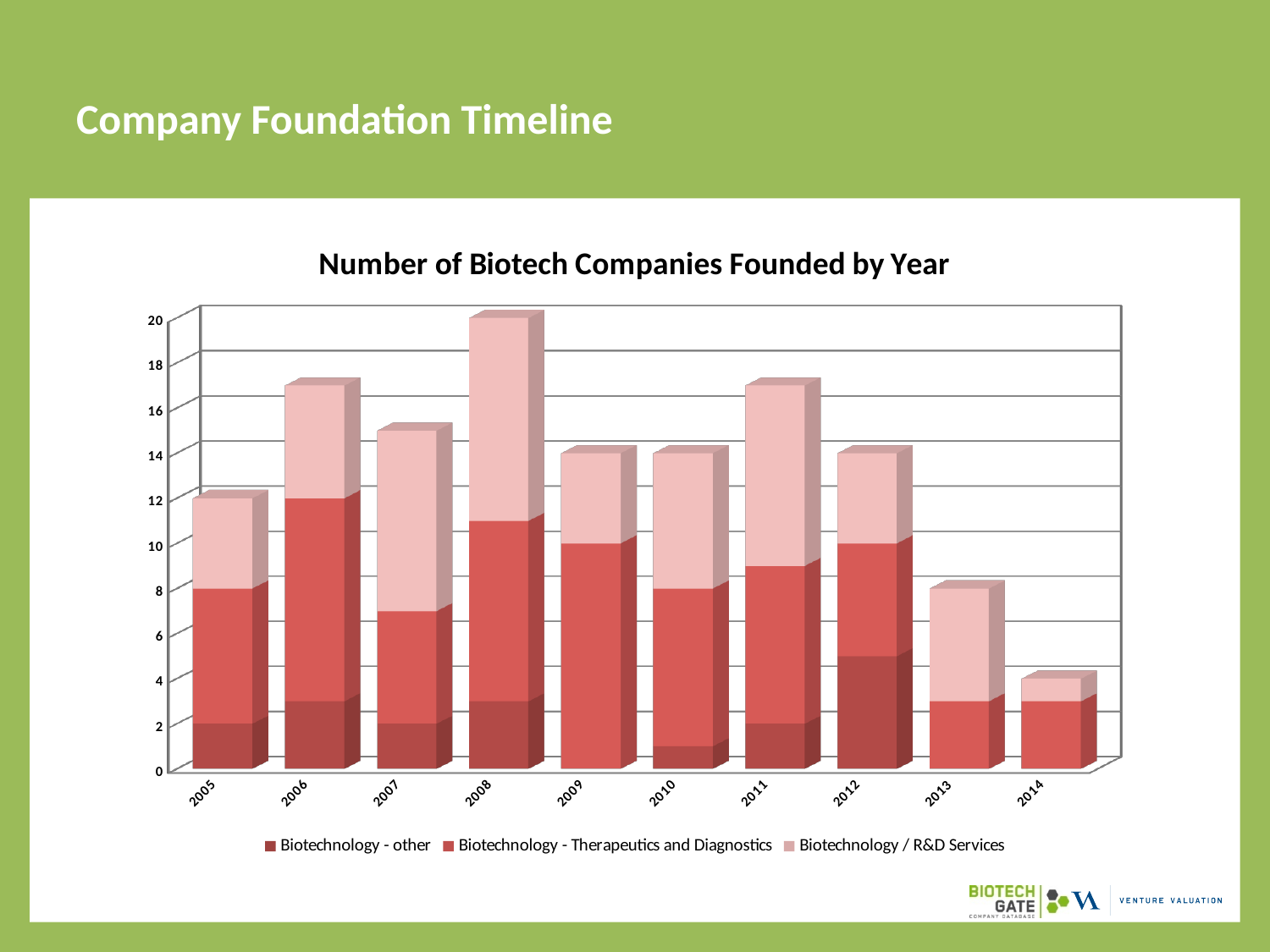
Is the total for 2013 greater or less than 10? less Which year has a larger total, 2006 or 2013? 2006 How many series does the legend list? 3 Which year has the highest total number of biotech companies founded? 2008 What is the title of the chart? Number of Biotech Companies Founded by Year Is the total for 2014 greater or less than 6? less Which year has the lowest total number of biotech companies founded? 2014 Do the totals rise or fall from 2012 to 2014? fall What kind of chart is shown on the slide? bar chart Which legend entry is shown in the lightest pink colour? Biotechnology / R&D Services How many years are shown on the x axis? 10 Is the total for 2011 greater or less than 16? greater